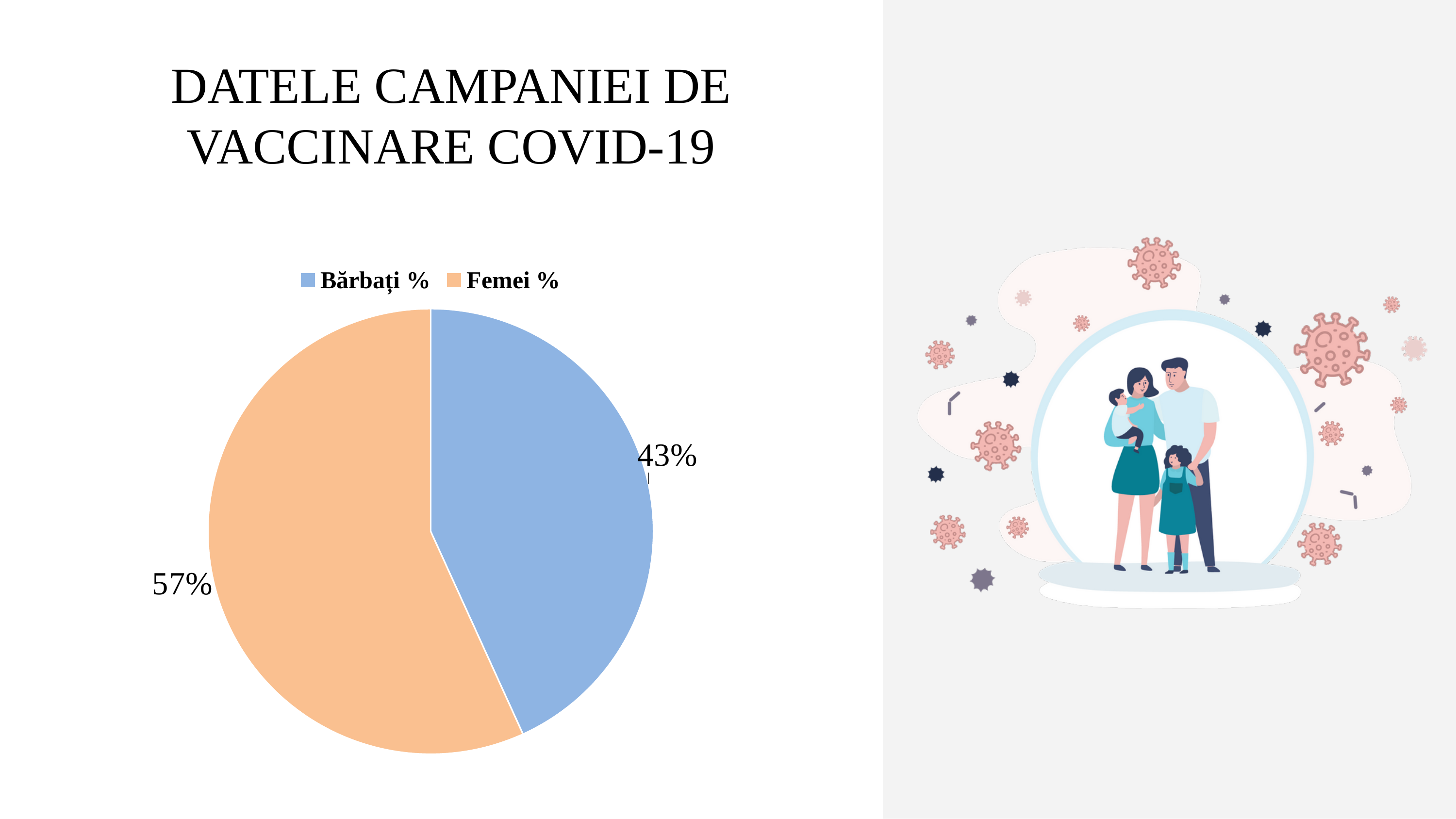
What is the value for Femei %? 57% What kind of chart is shown on the slide? pie chart What is the difference between the Femei % and Bărbați % values? 14% What is the value for Bărbați %? 43% What share of the pie does the Femei % slice represent? 57% How many entries does the legend list? 2 Which category has the smallest slice of the pie? Bărbați % Which category has the largest slice of the pie? Femei % How many slices does the pie chart have? 2 What colour is the Bărbați % slice? blue What is the title of the slide containing the chart? DATELE CAMPANIEI DE VACCINARE COVID-19 Which is larger, the value for Bărbați % or the value for Femei %? Femei %